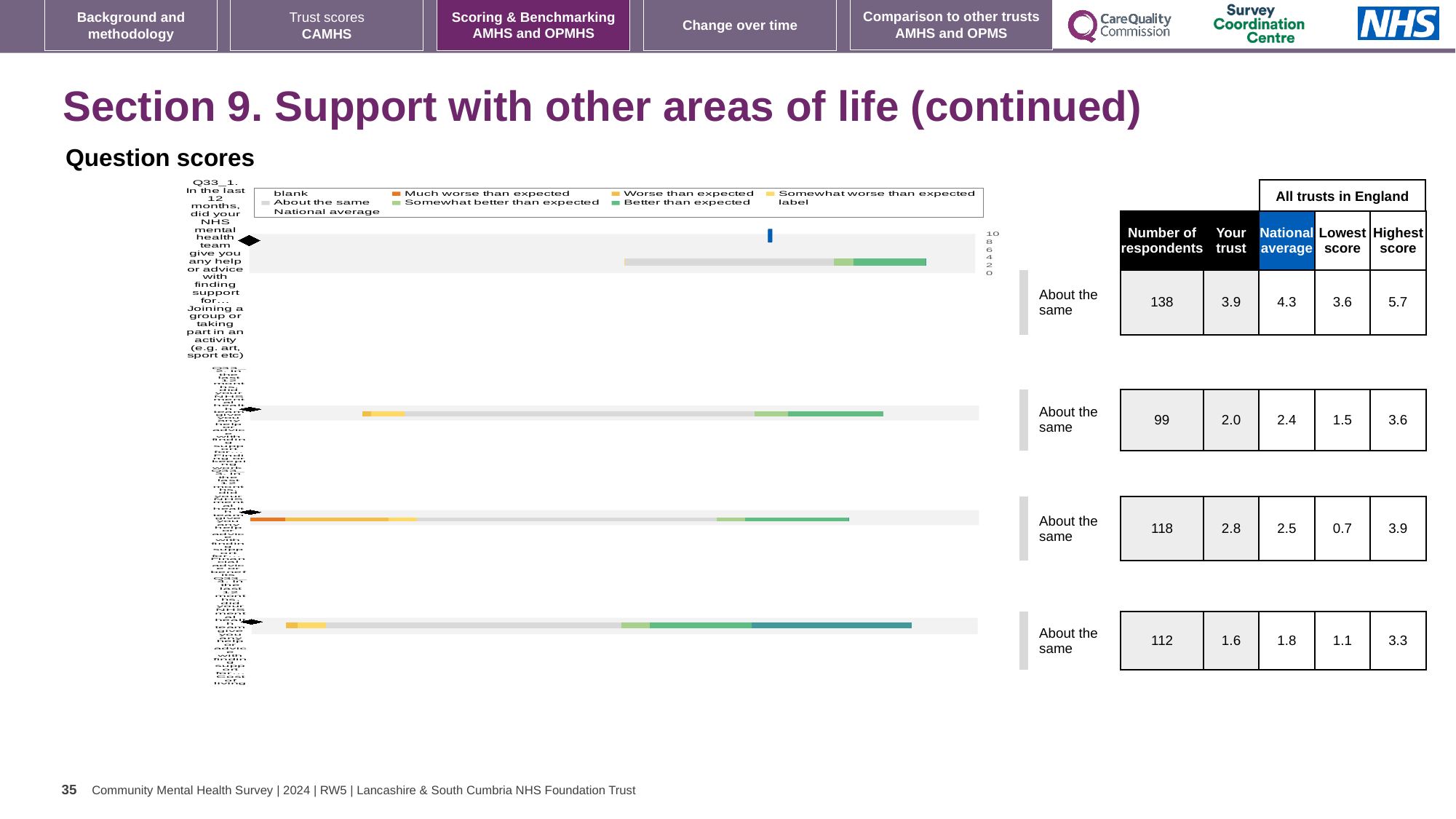
Which legend entry is shown in dark blue in the chart? National average What kind of chart is shown under 'Question scores'? bar chart Which of the four bars has the lowest number of respondents? the second bar (99) What is the national average shown for Q33_1 (the first bar)? 4.3 What benchmark label is shown next to each of the four bars? About the same What is the 'Your trust' score shown for Q33_1 (the first bar)? 3.9 Which of the four bars has the highest 'Your trust' score? Q33_1 (the first bar) How many question bars are plotted in the chart? 4 How many entries does the chart legend list? 9 How many respondents are shown for Q33_1 (the first bar)? 138 What is the difference between the highest score and the lowest score shown for the first bar (Q33_1)? 2.1 What is the highest score across all trusts in England shown for the first bar (Q33_1)? 5.7